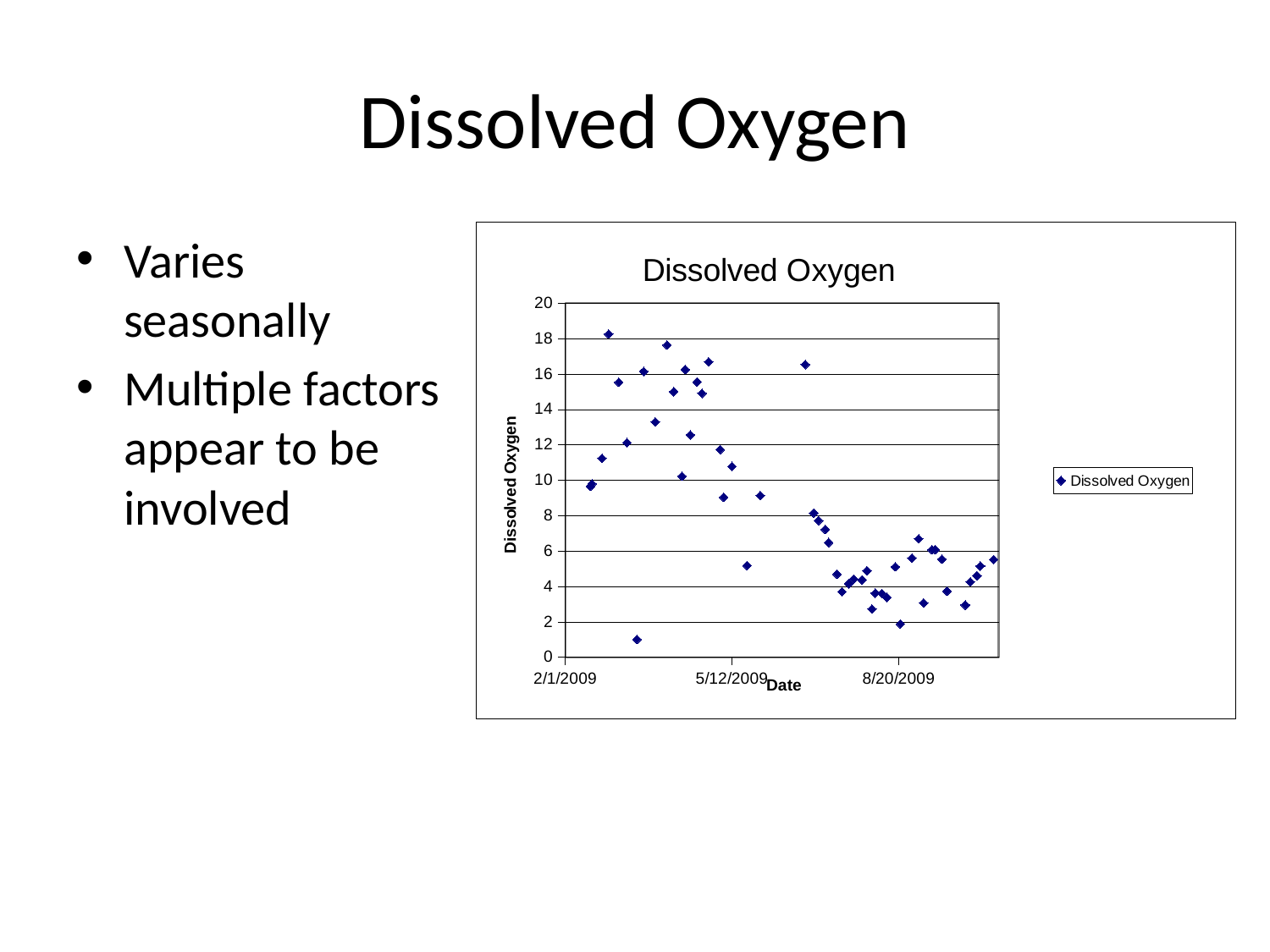
Is the highest plotted dissolved oxygen value greater or less than 18? greater What is the title of the chart? Dissolved Oxygen What is the label on the vertical axis of the chart? Dissolved Oxygen What kind of chart is shown on the slide? Scatter chart How many series does the chart legend list? 1 Do the dissolved oxygen values generally rise or fall from 2/1/2009 to 8/20/2009? Fall What is the maximum value shown on the vertical axis of the chart? 20 Are the dissolved oxygen values plotted near 2/1/2009 greater or less than 8? greater